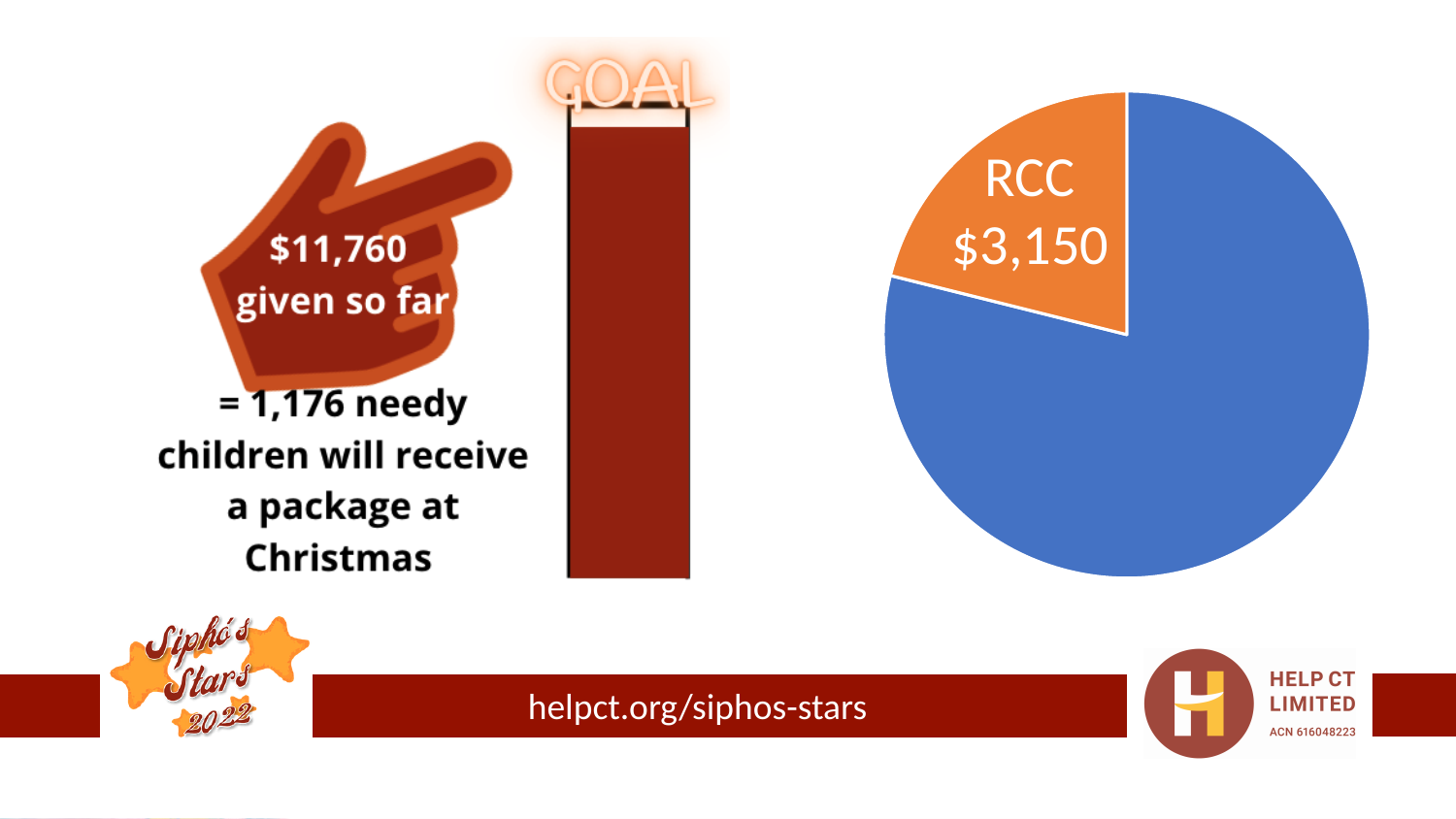
Which slice of the pie chart is labelled with a name and value? RCC What colour is the RCC slice in the pie chart? orange In the pie chart, which slice is larger, the orange RCC slice or the blue slice? the blue slice How many slices does the pie chart have? 2 In the pie chart, what value is shown for the RCC slice? $3,150 In the pie chart, is the RCC slice the largest or the smallest slice? smallest What kind of chart is shown on the right side of the slide? pie chart